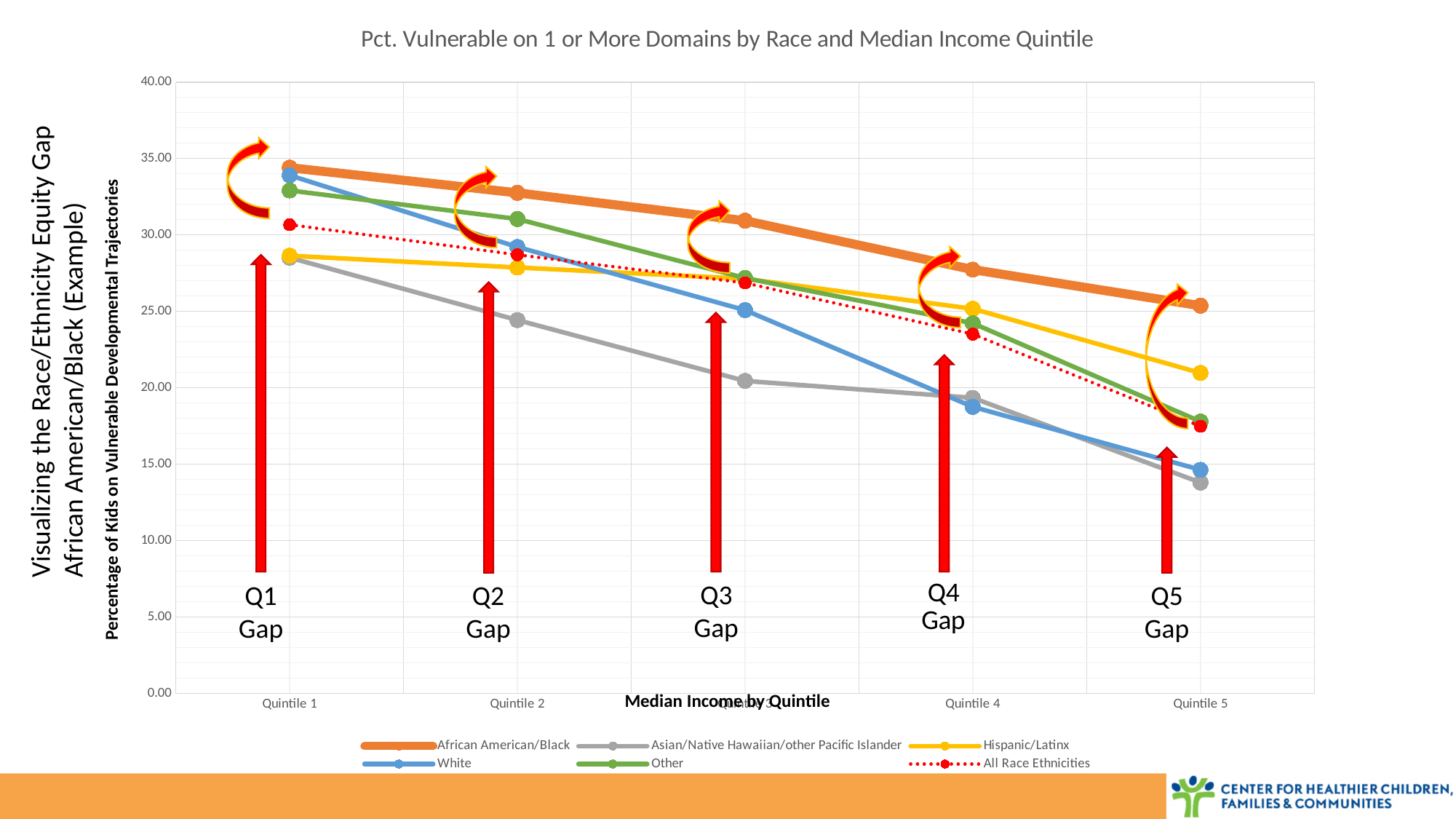
Which series has the lowest value at Quintile 3? Asian/Native Hawaiian/other Pacific Islander How many income quintiles are plotted along the x axis? 5 Which series has the highest value at Quintile 3? African American/Black Which series has the highest value at Quintile 5? African American/Black What is the title of the chart? Pct. Vulnerable on 1 or More Domains by Race and Median Income Quintile Is the value for White at Quintile 4 greater or less than 20.00? less How many series does the legend list? 6 At Quintile 2, which is larger: White or Asian/Native Hawaiian/other Pacific Islander? White Does the African American/Black line rise or fall from Quintile 1 to Quintile 5? fall Is the value for Hispanic/Latinx at Quintile 5 greater or less than 25.00? less Is the value for African American/Black at Quintile 1 greater or less than 30.00? greater What kind of chart is shown on the slide? line chart